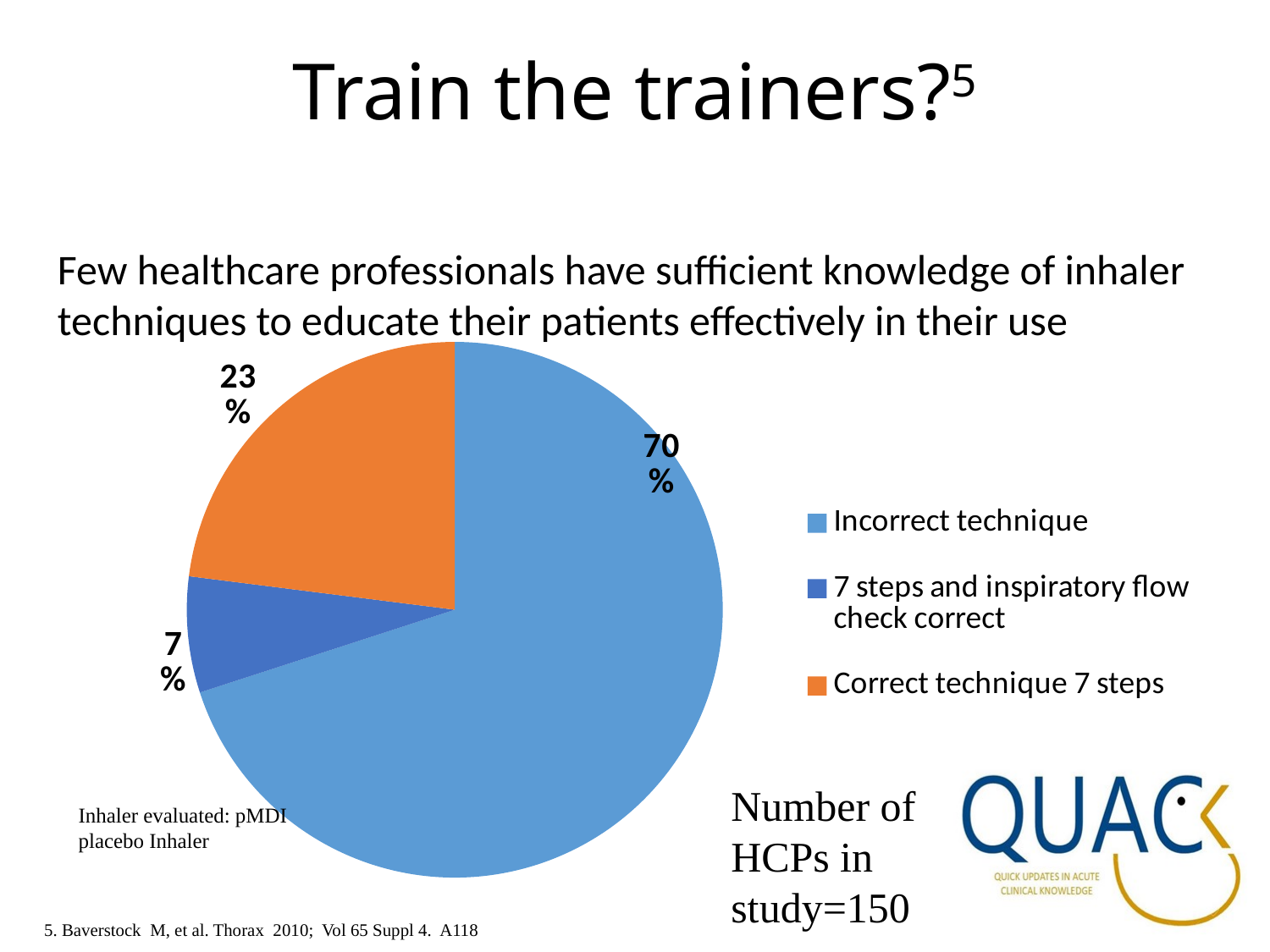
How many entries does the legend list? 3 What percentage of the pie is labelled for Incorrect technique? 70% Which is larger: the Correct technique 7 steps slice or the 7 steps and inspiratory flow check correct slice? Correct technique 7 steps What is the difference in percentage points between the Incorrect technique slice and the Correct technique 7 steps slice? 47 Which category has the smallest slice of the pie? 7 steps and inspiratory flow check correct What kind of chart is shown on the slide? pie chart Which category has the largest slice of the pie? Incorrect technique What percentage of the pie is labelled for Correct technique 7 steps? 23% What percentage of the pie is labelled for 7 steps and inspiratory flow check correct? 7% What colour is the Correct technique 7 steps slice? orange How many slices does the pie chart have? 3 What is the combined share of the two slices representing correct technique (Correct technique 7 steps and 7 steps and inspiratory flow check correct)? 30%